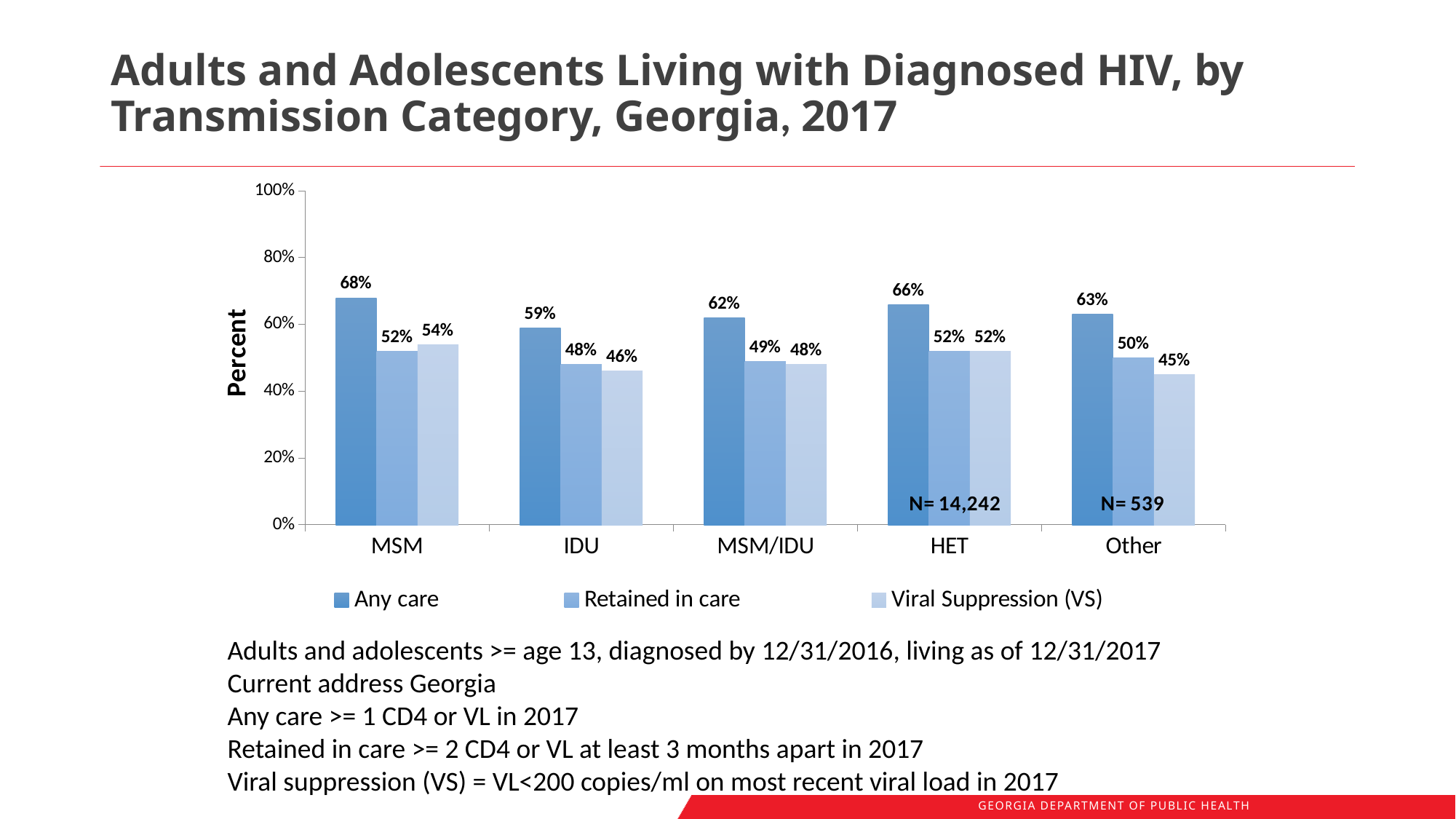
What is the label on the y axis? Percent Which transmission category has the lowest Viral Suppression (VS) value? Other Which transmission category has the highest Any care value? MSM How many series does the legend list? 3 What is the Viral Suppression (VS) value for IDU? 46% What kind of chart is shown on the slide? Bar chart What N value is printed for the HET category? N= 14,242 What is the Retained in care value for HET? 52% What is the difference between the Any care value and the Retained in care value for MSM/IDU? 13% What is the Any care value for MSM? 68% How many transmission categories are shown on the x axis? 5 Which is larger, the Any care value for IDU or the Any care value for Other? Other